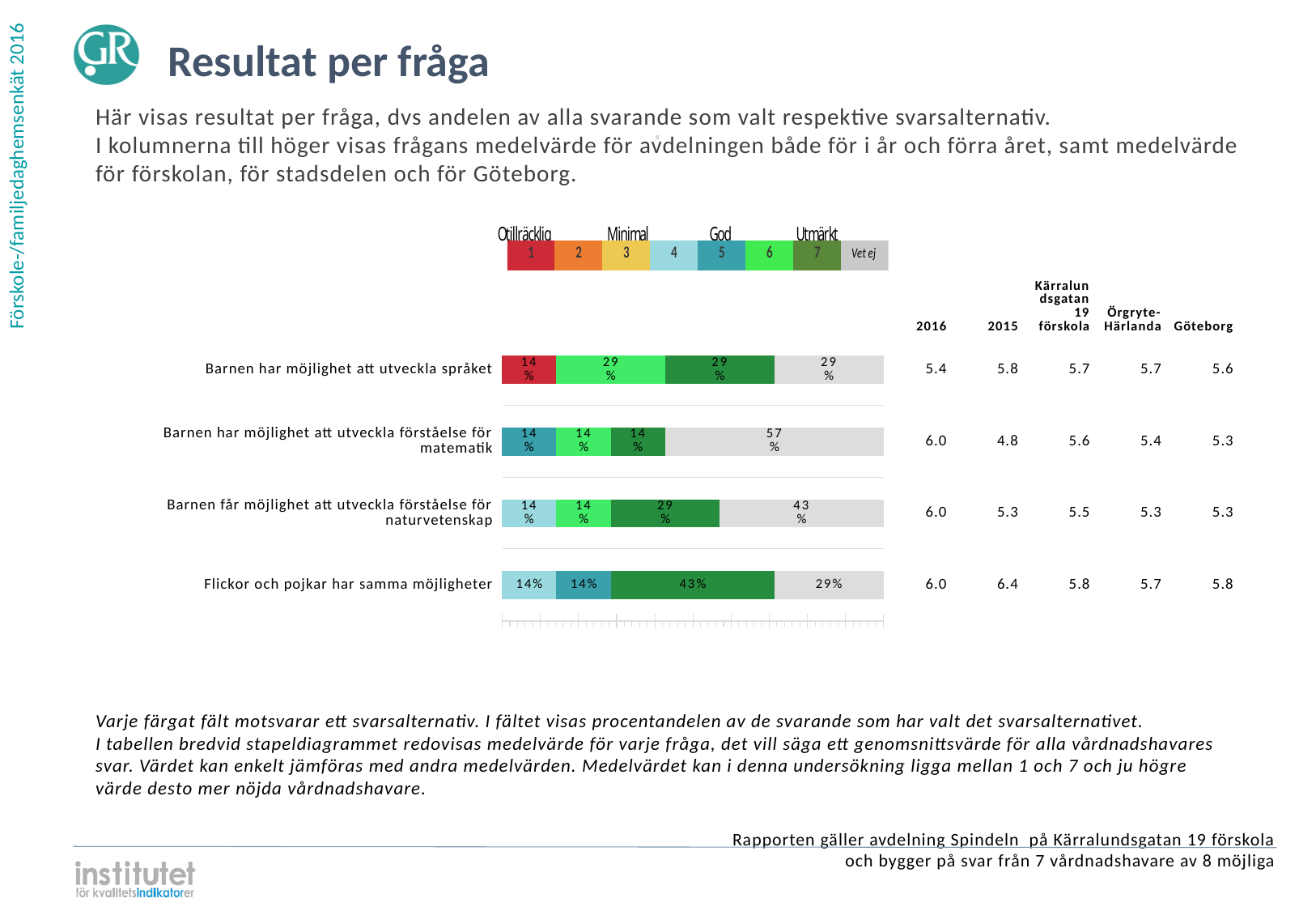
What is the 2016 mean value shown for 'Barnen har möjlighet att utveckla språket'? 5.4 What percentage of respondents chose option 7 (dark green) for 'Flickor och pojkar har samma möjligheter'? 43% What kind of chart is used to show the results per question? Stacked bar chart What is the 2015 mean value shown for 'Flickor och pojkar har samma möjligheter'? 6.4 How many questions (categories) are shown as bars in the chart? 4 What percentage of respondents chose option 1 (red) for 'Barnen har möjlighet att utveckla språket'? 14% Which is larger: the option 7 share for 'Flickor och pojkar har samma möjligheter' or the option 7 share for 'Barnen har möjlighet att utveckla förståelse för matematik'? Flickor och pojkar har samma möjligheter What is the difference between the 'Vet ej' share for 'Barnen har möjlighet att utveckla förståelse för matematik' (57%) and for 'Barnen får möjlighet att utveckla förståelse för naturvetenskap' (43%)? 14% How many response options does the legend above the chart list, including 'Vet ej'? 8 Which question has the largest 'Vet ej' share? Barnen har möjlighet att utveckla förståelse för matematik What percentage of respondents answered 'Vet ej' for 'Barnen har möjlighet att utveckla förståelse för matematik'? 57% Which response option in the legend is shown in red? 1 (Otillräcklig)